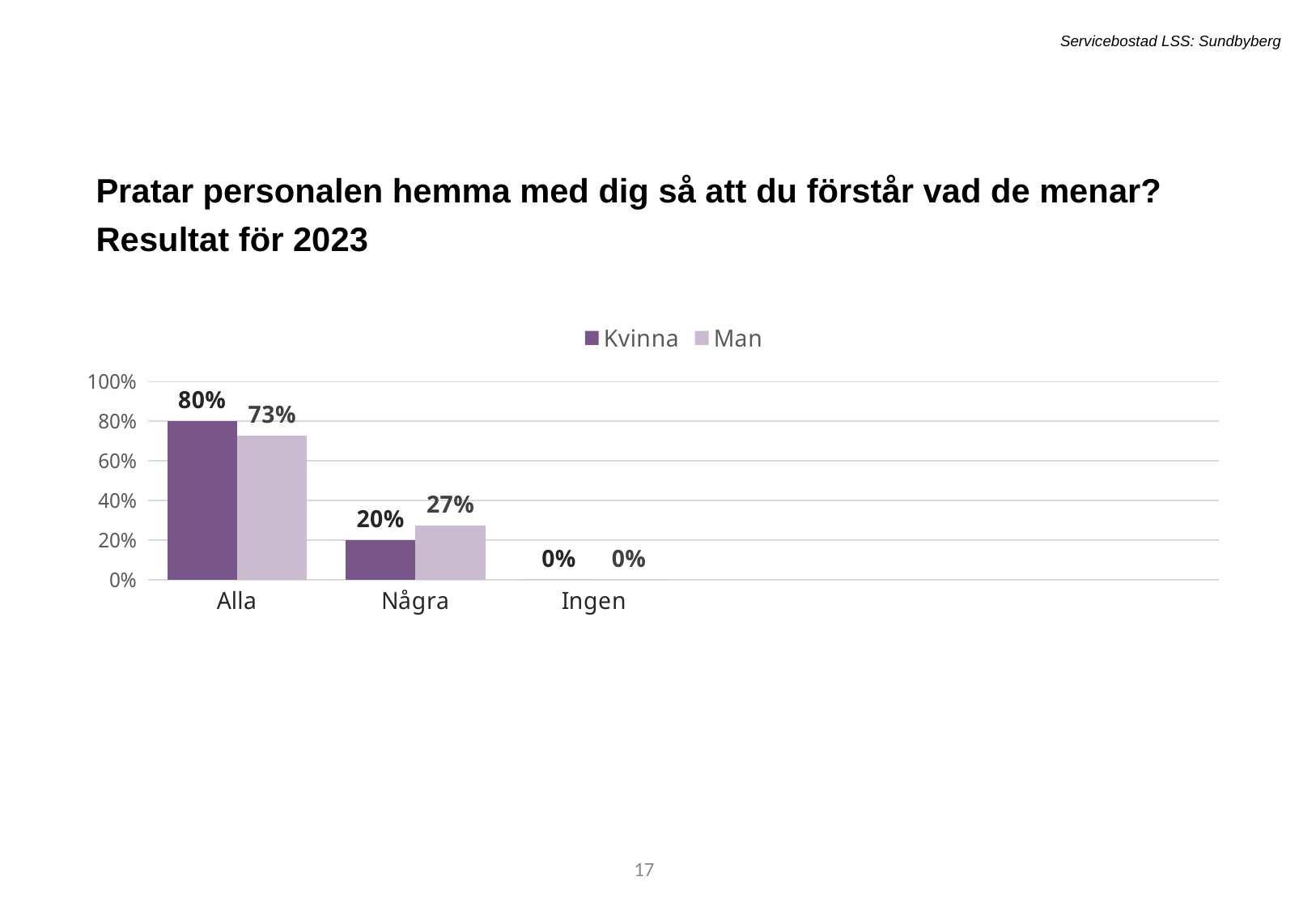
Which category has the highest value for Kvinna? Alla What is the value for Kvinna in the Ingen category? 0% What is the value for Kvinna in the Några category? 20% Which category has the lowest value for Man? Ingen What is the value for Kvinna in the Alla category? 80% What kind of chart is shown on the slide? Bar chart How many series does the legend list? 2 What is the value for Man in the Alla category? 73% What is the value for Man in the Några category? 27% In the Några category, which series has the larger value, Kvinna or Man? Man What is the difference between the Kvinna and Man values in the Alla category? 7% How many categories are shown on the x axis? 3